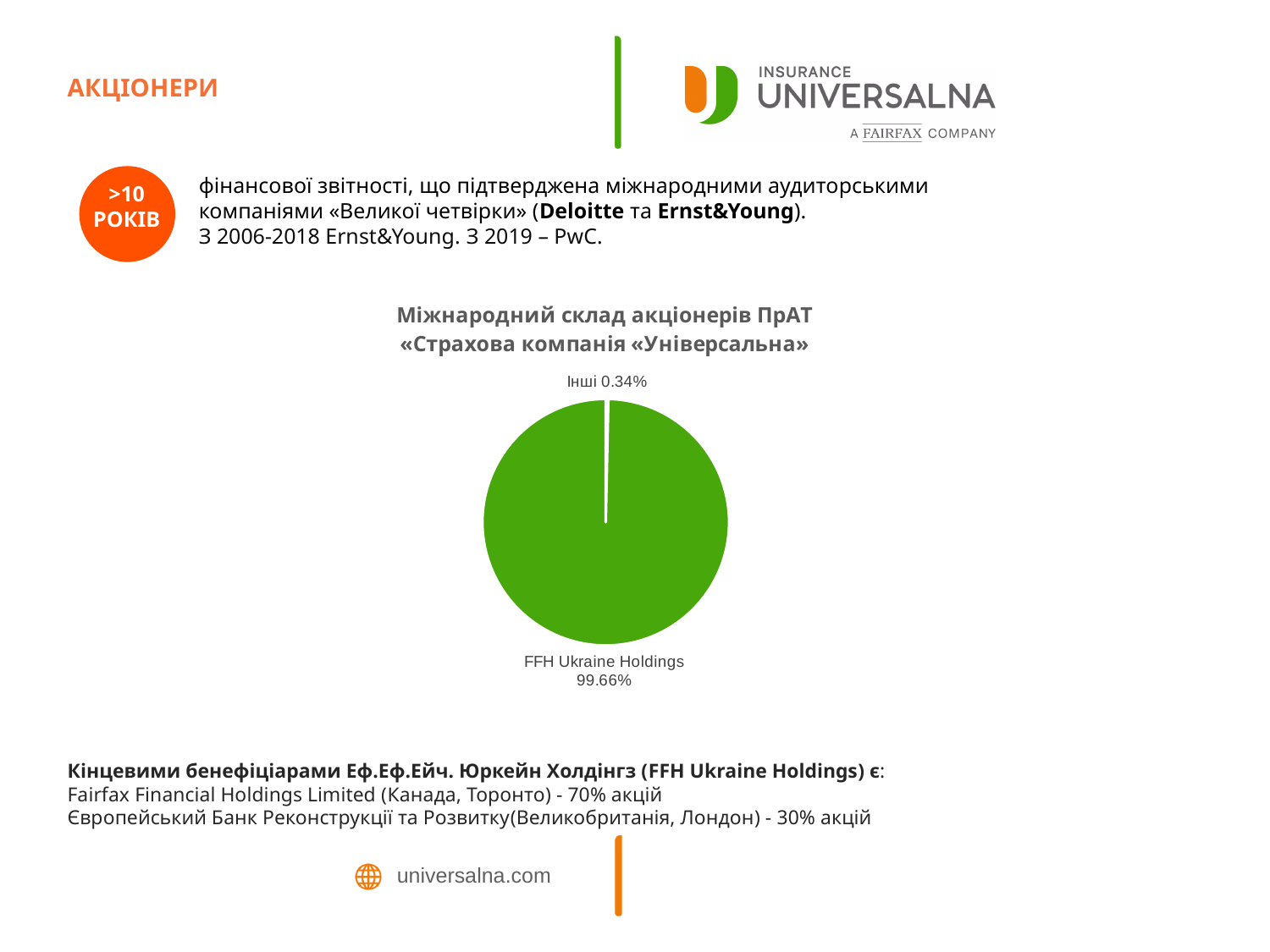
What share of the pie does the slice labelled Інші hold? 0.34% What colour is the FFH Ukraine Holdings slice of the pie chart? green Which slice of the pie chart is the largest? FFH Ukraine Holdings What share of the pie does FFH Ukraine Holdings hold? 99.66% What is the difference in percentage points between the FFH Ukraine Holdings slice and the Інші slice? 99.32 What kind of chart is shown on the slide? pie chart How many slices does the pie chart have? 2 Which is larger, the FFH Ukraine Holdings slice or the Інші slice? FFH Ukraine Holdings Which slice of the pie chart is the smallest? Інші What is the title of the pie chart? Міжнародний склад акціонерів ПрАТ «Страхова компанія «Універсальна» What is the total of the two slice percentages shown on the pie chart? 100%